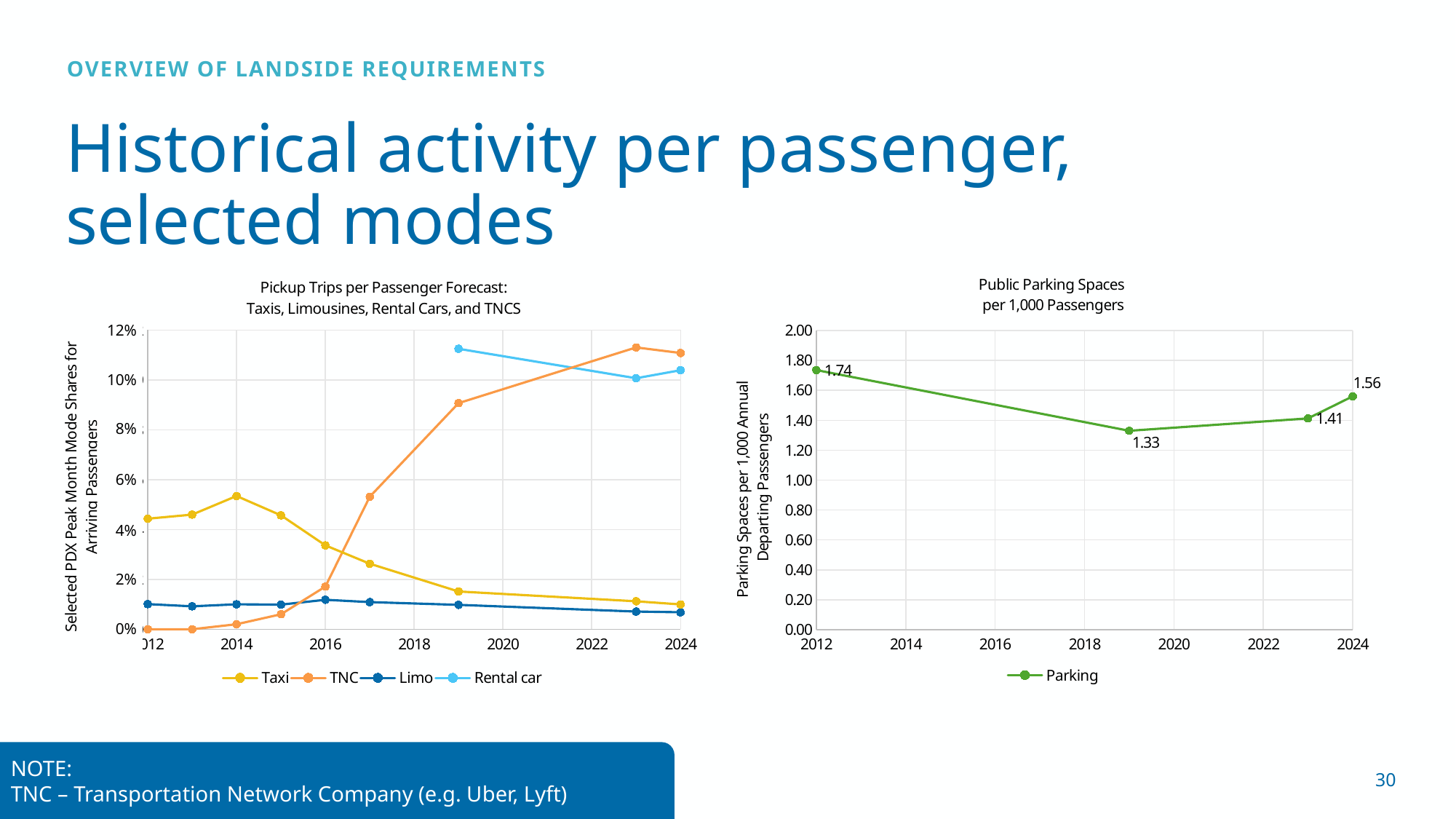
In the Pickup Trips per Passenger Forecast chart, is the TNC value for 2023 greater or less than 10%? greater In the Pickup Trips per Passenger Forecast chart, does the Taxi series rise or fall from 2014 to 2024? Fall In the Public Parking Spaces per 1,000 Passengers chart, what is the value for 2012? 1.74 In the Public Parking Spaces per 1,000 Passengers chart, which year has the highest value? 2012 In the Public Parking Spaces per 1,000 Passengers chart, what is the value for 2019? 1.33 In the Public Parking Spaces per 1,000 Passengers chart, which is larger, the value for 2023 or the value for 2024? 2024 How many series does the legend of the Pickup Trips per Passenger Forecast chart list? 4 In the Public Parking Spaces per 1,000 Passengers chart, what is the difference between the 2012 and 2019 values? 0.41 How many data points are plotted in the Public Parking Spaces per 1,000 Passengers chart? 4 What kind of chart is the Pickup Trips per Passenger Forecast chart? Line chart In the Public Parking Spaces per 1,000 Passengers chart, what is the value for 2024? 1.56 In the Public Parking Spaces per 1,000 Passengers chart, which year has the lowest value? 2019